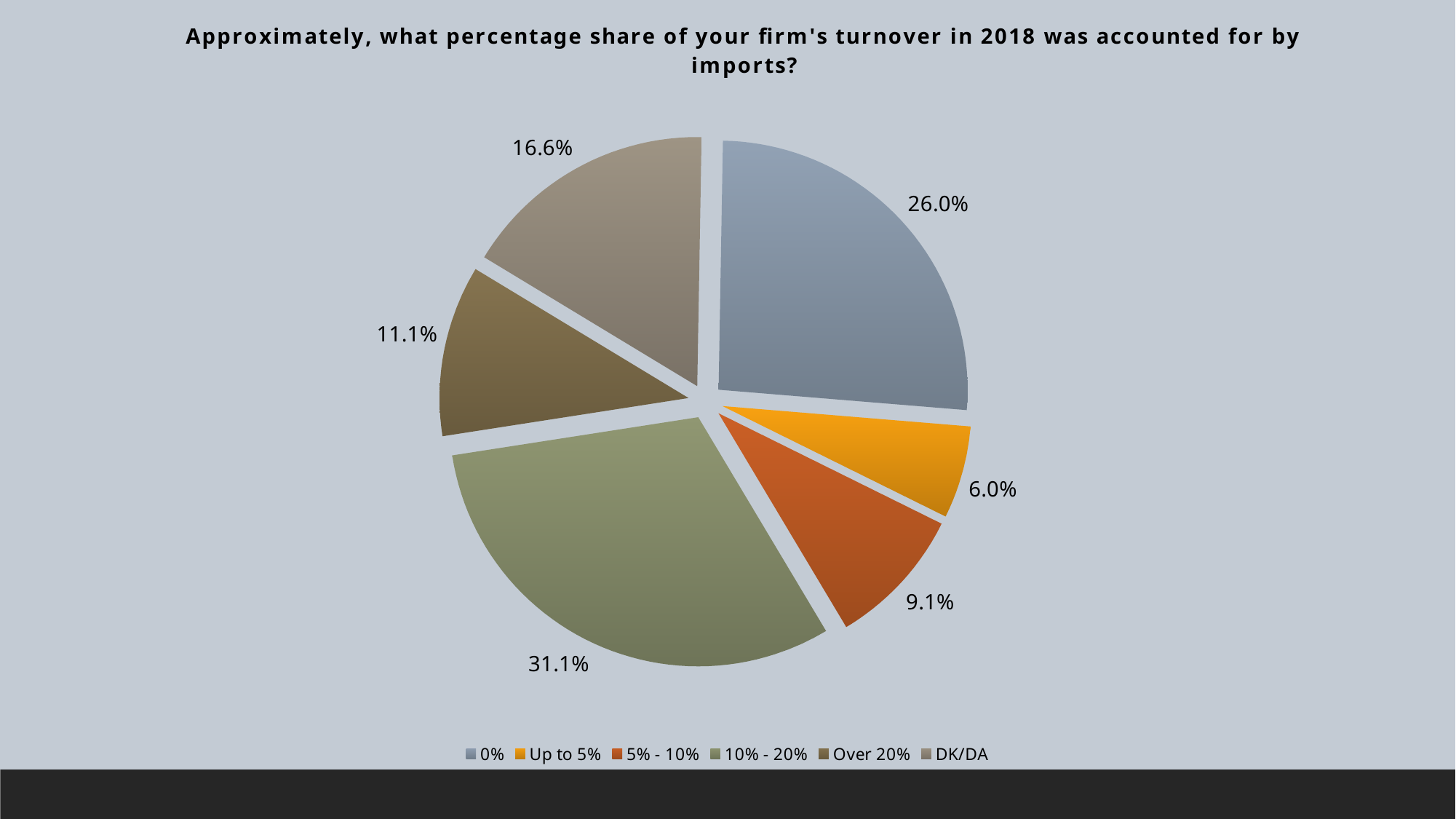
What share of respondents answered '0%'? 26.0% How many categories does the legend list? 6 What is the difference in percentage points between the '10% - 20%' slice and the '0%' slice? 5.1 percentage points Which category has the smallest slice of the pie? Up to 5% What share of respondents answered 'Up to 5%'? 6.0% What share of respondents answered 'Over 20%'? 11.1% What share of respondents answered '5% - 10%'? 9.1% What type of chart is shown on the slide? Pie chart What share of respondents answered 'DK/DA'? 16.6% Which category has the largest slice of the pie? 10% - 20% What share of respondents answered '10% - 20%'? 31.1% Which is larger, the 'DK/DA' slice or the 'Over 20%' slice? DK/DA